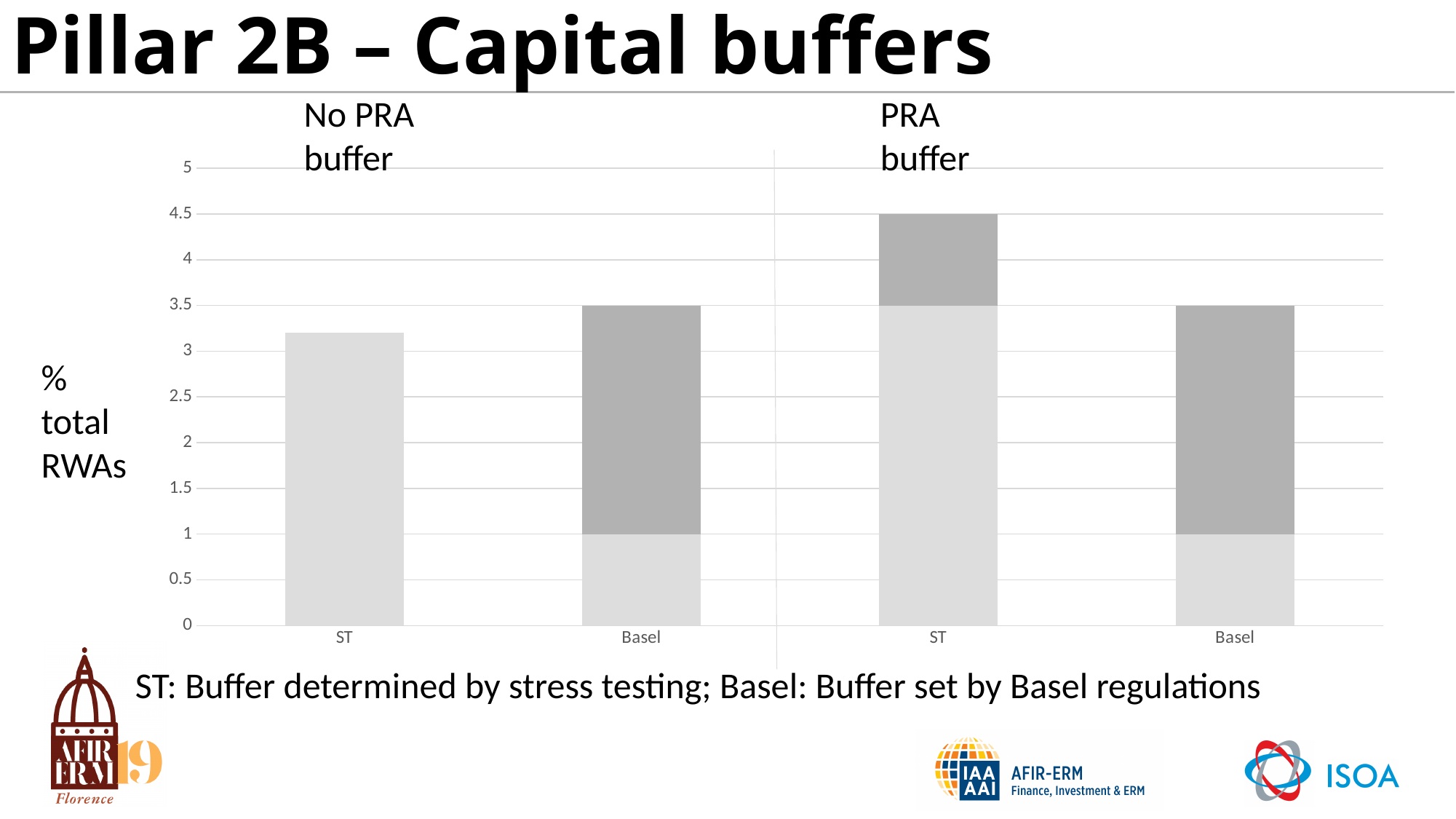
What is the total height of the Basel bar under No PRA buffer? 3.5 What is the label on the vertical axis of the chart? % total RWAs What kind of chart is shown on the slide? bar chart Is the value for ST under No PRA buffer greater or less than 3.5? less Is the value for ST under No PRA buffer greater or less than 3? greater How many bars are plotted in the chart? 4 What is the total height of the ST bar under PRA buffer? 4.5 What are the two group headings shown above the chart? No PRA buffer and PRA buffer What is the difference between the total of the ST bar under PRA buffer and the Basel bar under PRA buffer? 1 Which is larger: the ST bar under No PRA buffer or the Basel bar under No PRA buffer? Basel under No PRA buffer Which bar reaches the highest value in the chart? ST under PRA buffer Which bar has the lowest total value in the chart? ST under No PRA buffer